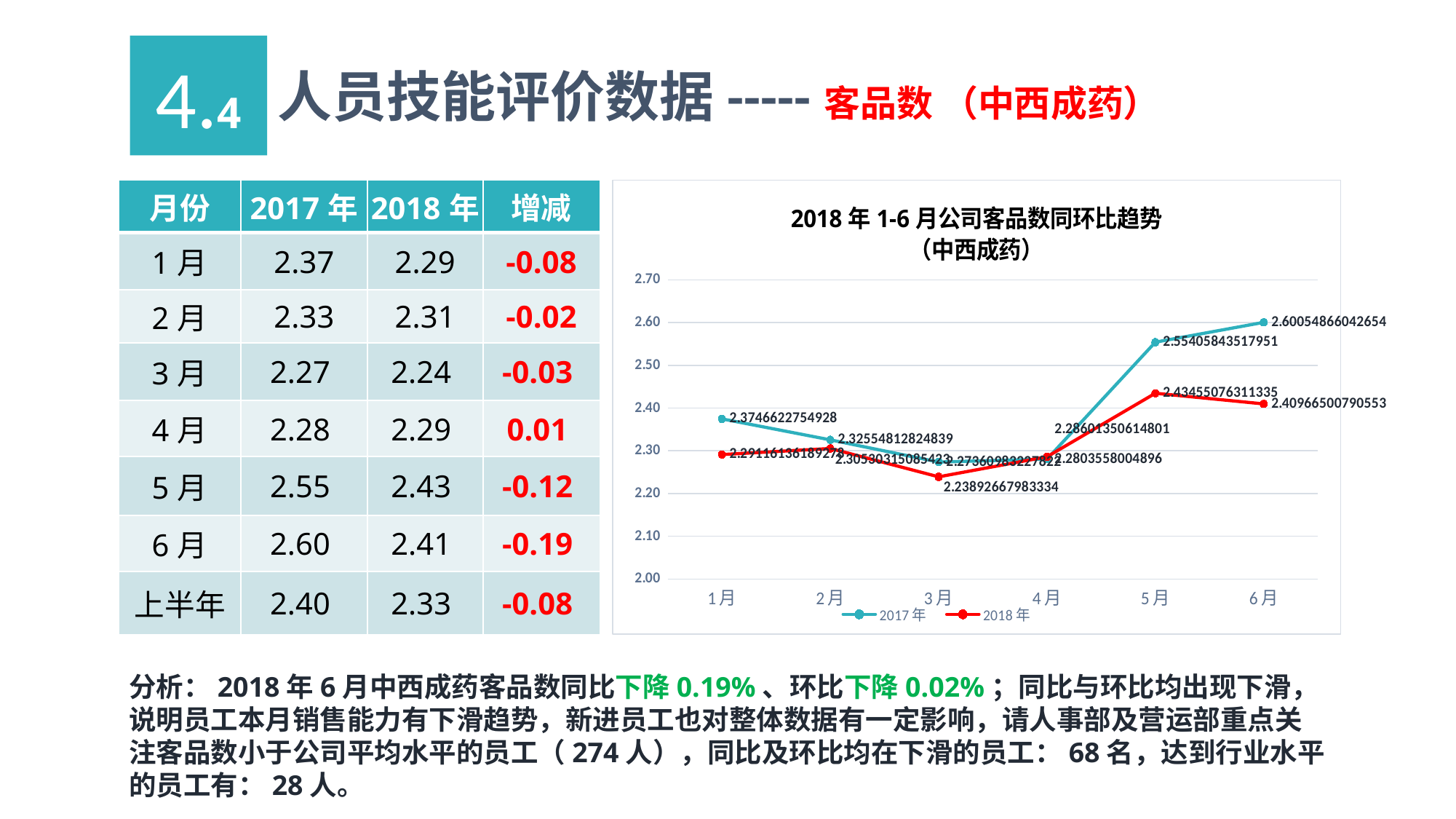
In the chart, which month has the highest value for the 2017年 series? 6月 In the chart, what is the data label for 2018年 in 5月? 2.43455076311335 How many months are plotted along the x axis of the chart? 6 In the chart, which month has the lowest value for the 2018年 series? 3月 In the chart, is the 2017年 value for 5月 greater or less than 2.50? greater In the chart, what is the data label for 2018年 in 3月? 2.23892667983334 What kind of chart is shown on the slide? line chart In the chart, which series has the larger value in 6月, 2017年 or 2018年? 2017年 In the chart, what is the data label for 2018年 in 6月? 2.40966500790553 What is the title of the chart? 2018年1-6月公司客品数同环比趋势（中西成药） In the chart, what is the data label for 2017年 in 6月? 2.60054866042654 How many series does the chart legend list? 2